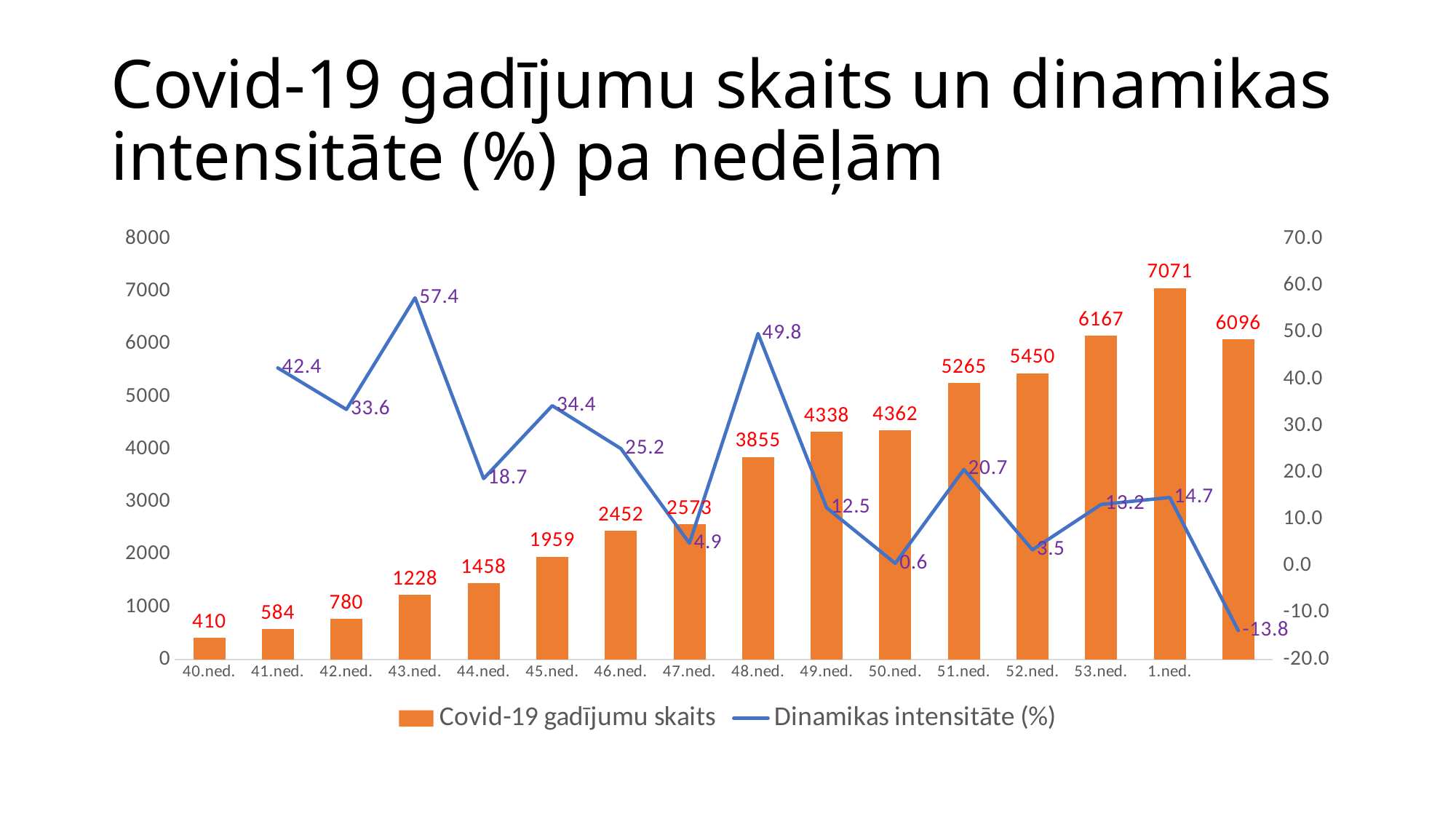
What is the difference in Covid-19 gadījumu skaits between 53.ned. and 52.ned.? 717 What is the Covid-19 gadījumu skaits value for 50.ned.? 4362 How many series does the legend list? 2 How many bars are plotted in the chart? 16 Which week has the highest Covid-19 gadījumu skaits? 1.ned. Is the Covid-19 gadījumu skaits for 49.ned. greater or less than 4000? greater What is the Dinamikas intensitāte (%) value for 48.ned.? 49.8 Which week has the lowest Covid-19 gadījumu skaits? 40.ned. What is the Covid-19 gadījumu skaits value for 45.ned.? 1959 Which is larger, the Dinamikas intensitāte (%) for 41.ned. or for 42.ned.? 41.ned. What kind of chart is shown on the slide? Combined bar and line chart Which week has the highest Dinamikas intensitāte (%)? 43.ned.